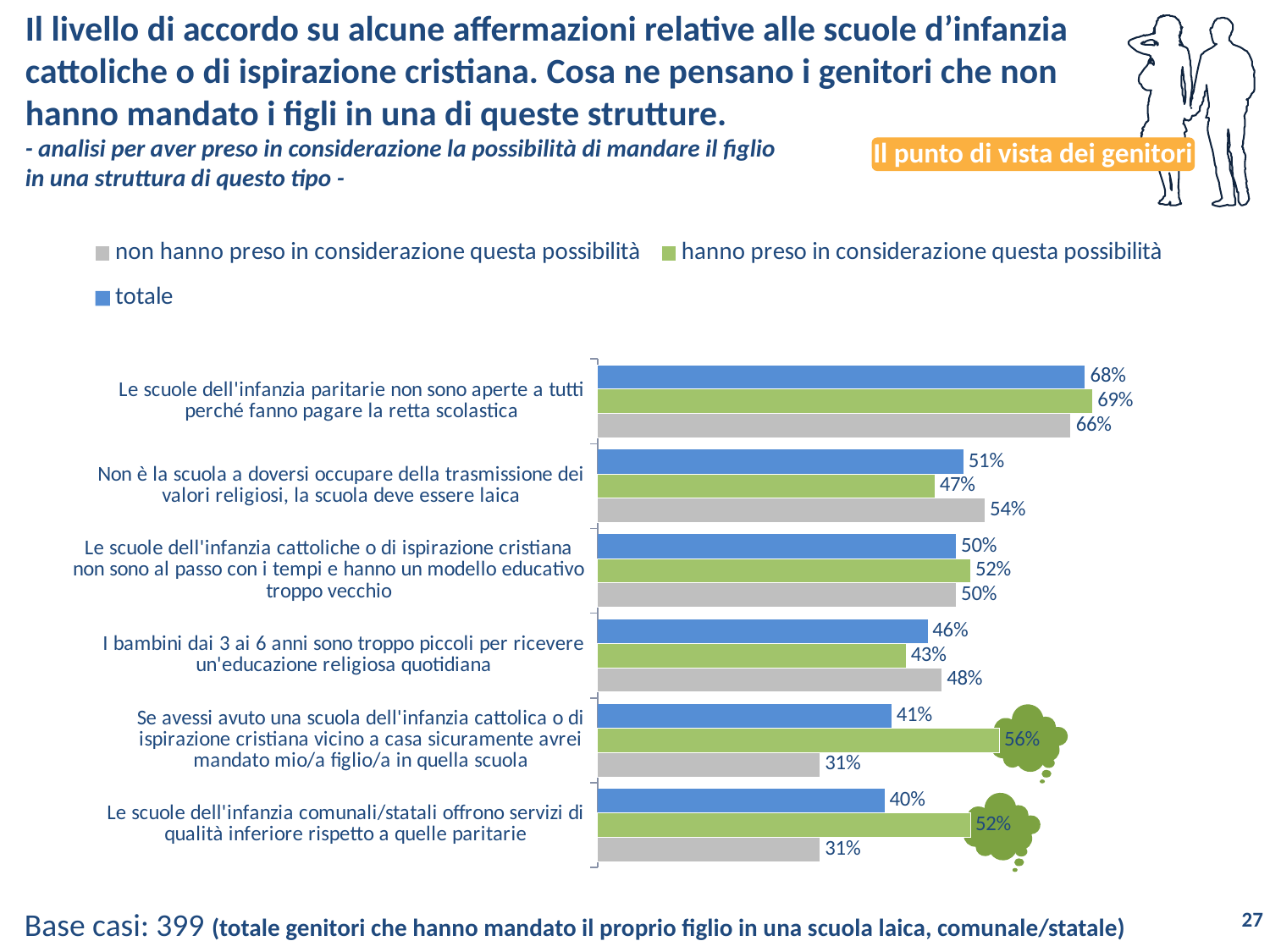
What is the difference between the 'hanno preso in considerazione' and 'non hanno preso in considerazione' values for 'Se avessi avuto una scuola dell'infanzia cattolica o di ispirazione cristiana vicino a casa sicuramente avrei mandato mio/a figlio/a in quella scuola'? 25% What is the 'non hanno preso in considerazione questa possibilità' value for 'I bambini dai 3 ai 6 anni sono troppo piccoli per ricevere un'educazione religiosa quotidiana'? 48% Which statement has the highest 'totale' value? Le scuole dell'infanzia paritarie non sono aperte a tutti perché fanno pagare la retta scolastica Which colour represents the 'totale' series in the chart? blue What is the value for 'hanno preso in considerazione questa possibilità' for 'Se avessi avuto una scuola dell'infanzia cattolica o di ispirazione cristiana vicino a casa sicuramente avrei mandato mio/a figlio/a in quella scuola'? 56% How many series does the legend list? 3 For 'Non è la scuola a doversi occupare della trasmissione dei valori religiosi, la scuola deve essere laica', which is larger: the 'hanno preso in considerazione' value or the 'non hanno preso in considerazione' value? non hanno preso in considerazione questa possibilità How many statements (categories) are plotted in the chart? 6 What is the value for 'non hanno preso in considerazione questa possibilità' for 'Le scuole dell'infanzia comunali/statali offrono servizi di qualità inferiore rispetto a quelle paritarie'? 31% Which statement has the lowest 'totale' value? Le scuole dell'infanzia comunali/statali offrono servizi di qualità inferiore rispetto a quelle paritarie What is the 'totale' value for 'Le scuole dell'infanzia paritarie non sono aperte a tutti perché fanno pagare la retta scolastica'? 68% What kind of chart is shown on the slide? bar chart